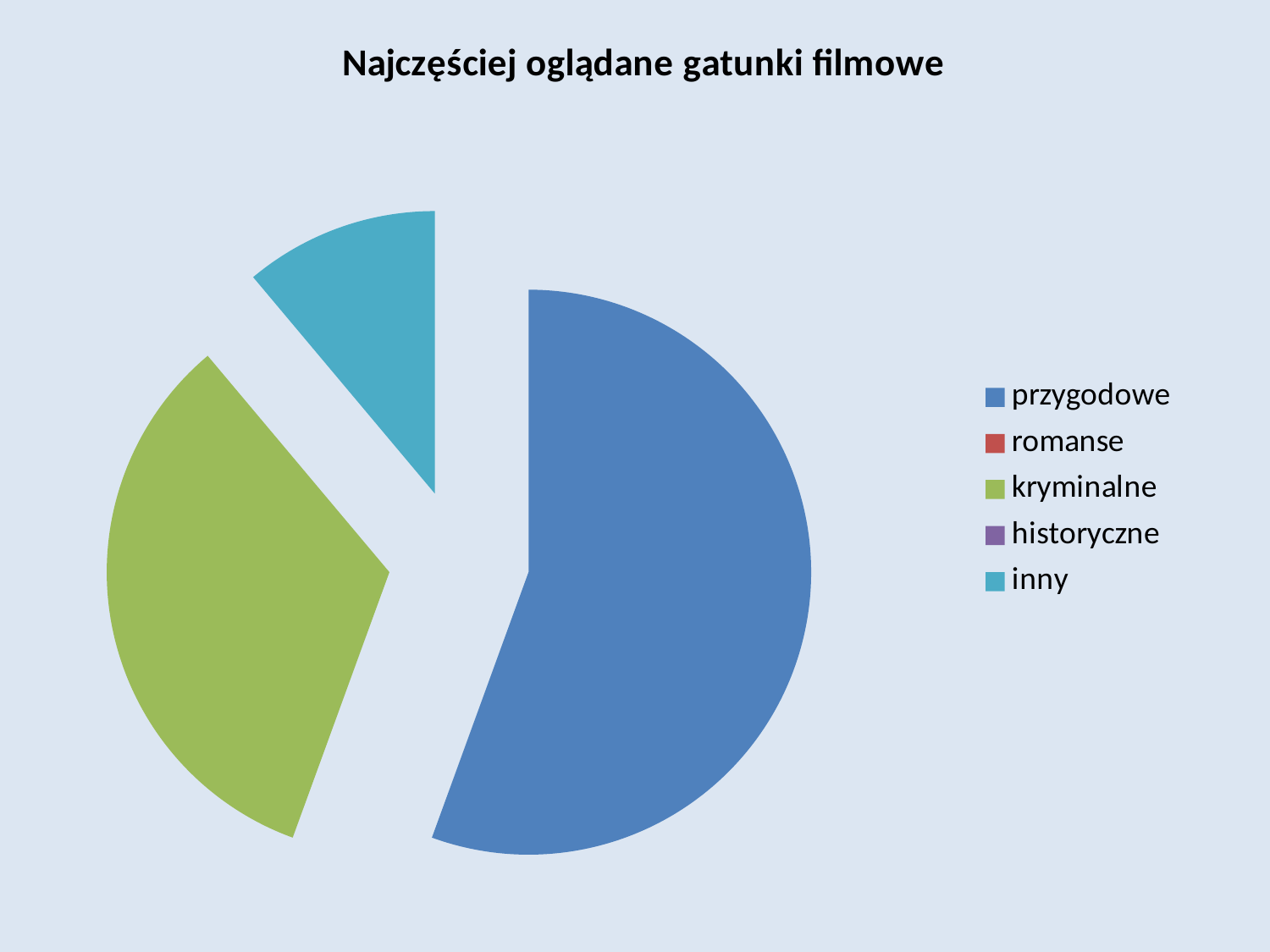
How many entries does the chart's legend list? 5 Which is larger, the slice for inny or the slice for przygodowe? przygodowe Which is larger, the slice for przygodowe or the slice for kryminalne? przygodowe Which category has the largest slice of the pie? przygodowe How many slices are visible in the pie? 3 Which is larger, the slice for kryminalne or the slice for inny? kryminalne What kind of chart is shown on the slide? pie chart Which category has the smallest visible slice of the pie? inny What is the title of the chart? Najczęściej oglądane gatunki filmowe Which legend entry is shown in green? kryminalne